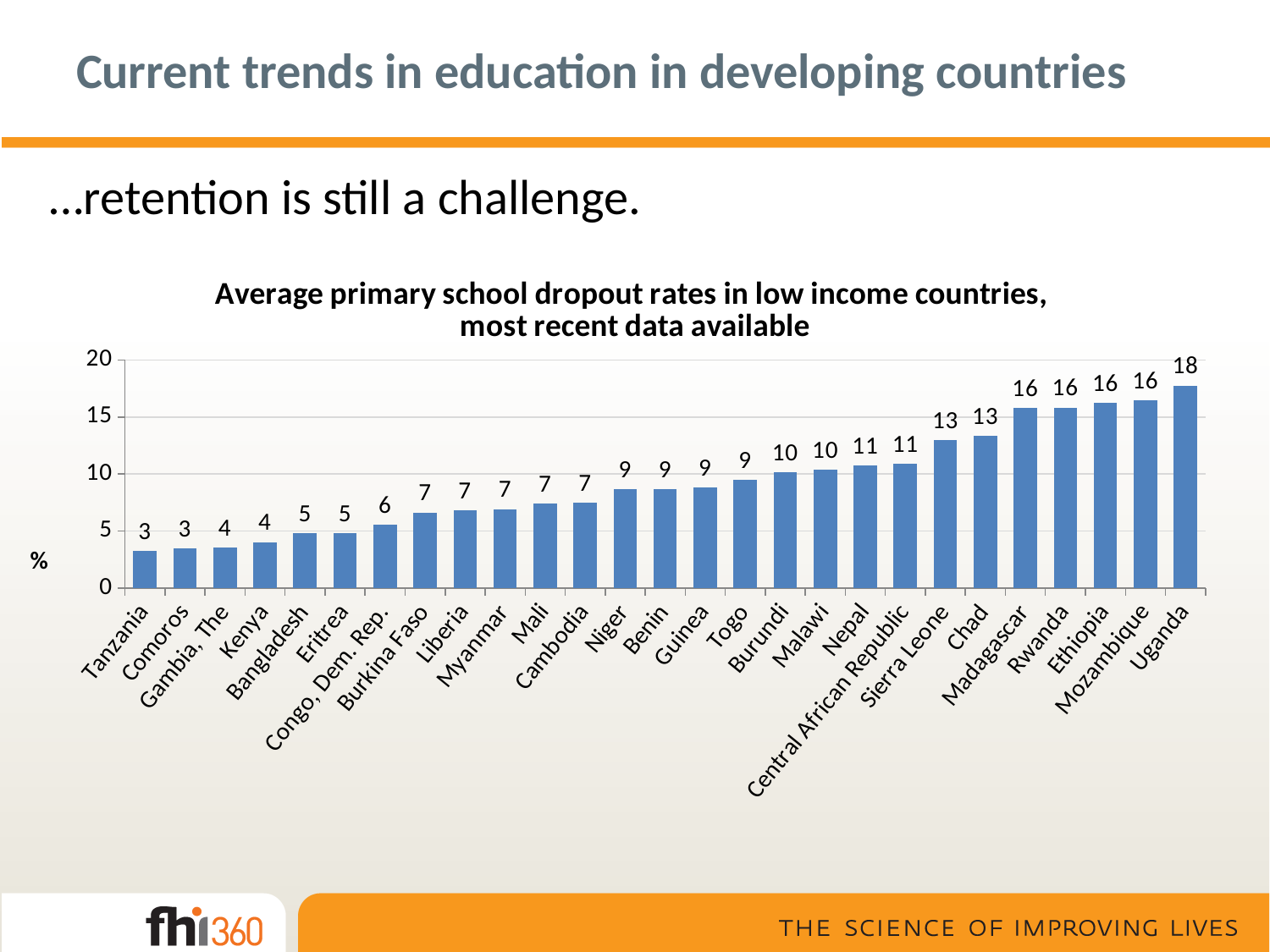
Which has a higher value, Chad or Kenya? Chad What kind of chart is shown on the slide? Bar chart Is the value for Madagascar greater or less than 15? greater Which country has the highest dropout rate in the chart? Uganda How many countries are shown in the chart? 27 What is the value shown for Sierra Leone? 13 What is the difference between the values for Uganda and Tanzania? 15 Do the values rise or fall from left to right along the x axis? Rise What is the value shown for Nepal? 11 What is the lowest value shown in the chart? 3 What is the difference between the values for Sierra Leone and Burundi? 3 What is the dropout rate shown for Uganda? 18